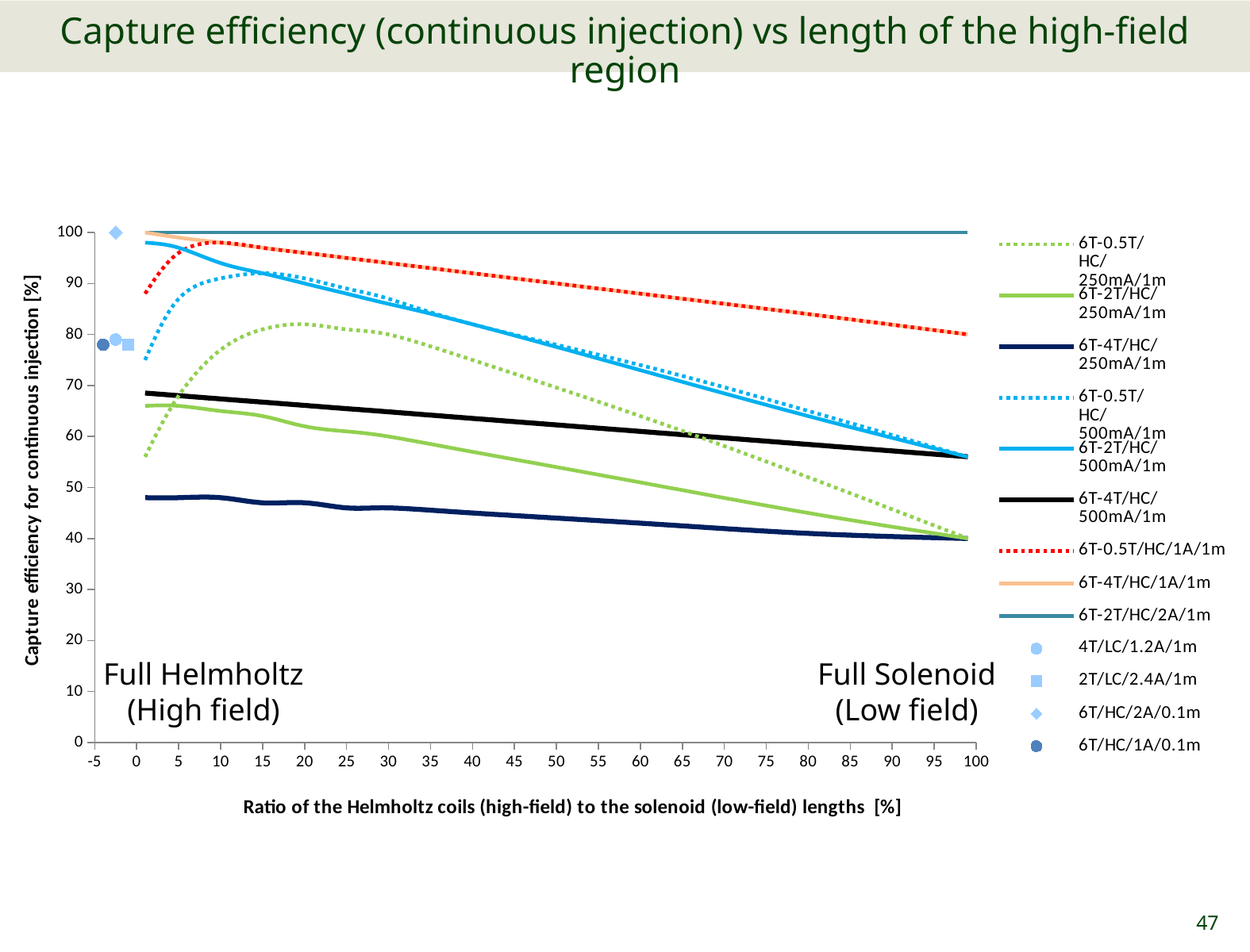
What is the label of the y axis? Capture efficiency for continuous injection [%] Does the 6T-4T/HC/500mA/1m series rise or fall as the x value increases? fall How many series does the legend list? 13 What is the title of the chart? Capture efficiency (continuous injection) vs length of the high-field region At x = 100, which series has the larger value: 6T-2T/HC/500mA/1m or 6T-2T/HC/250mA/1m? 6T-2T/HC/500mA/1m Which series stays highest across the whole x-axis range? 6T-2T/HC/2A/1m Which series has the lowest value at an x value of 50? 6T-4T/HC/250mA/1m Is the value for 6T-2T/HC/2A/1m greater or less than 90? greater Is the value for 6T-2T/HC/500mA/1m at x = 100 greater or less than 50? greater Is the value for 6T-4T/HC/250mA/1m at x = 50 greater or less than 50? less What kind of chart is shown on the slide? line chart